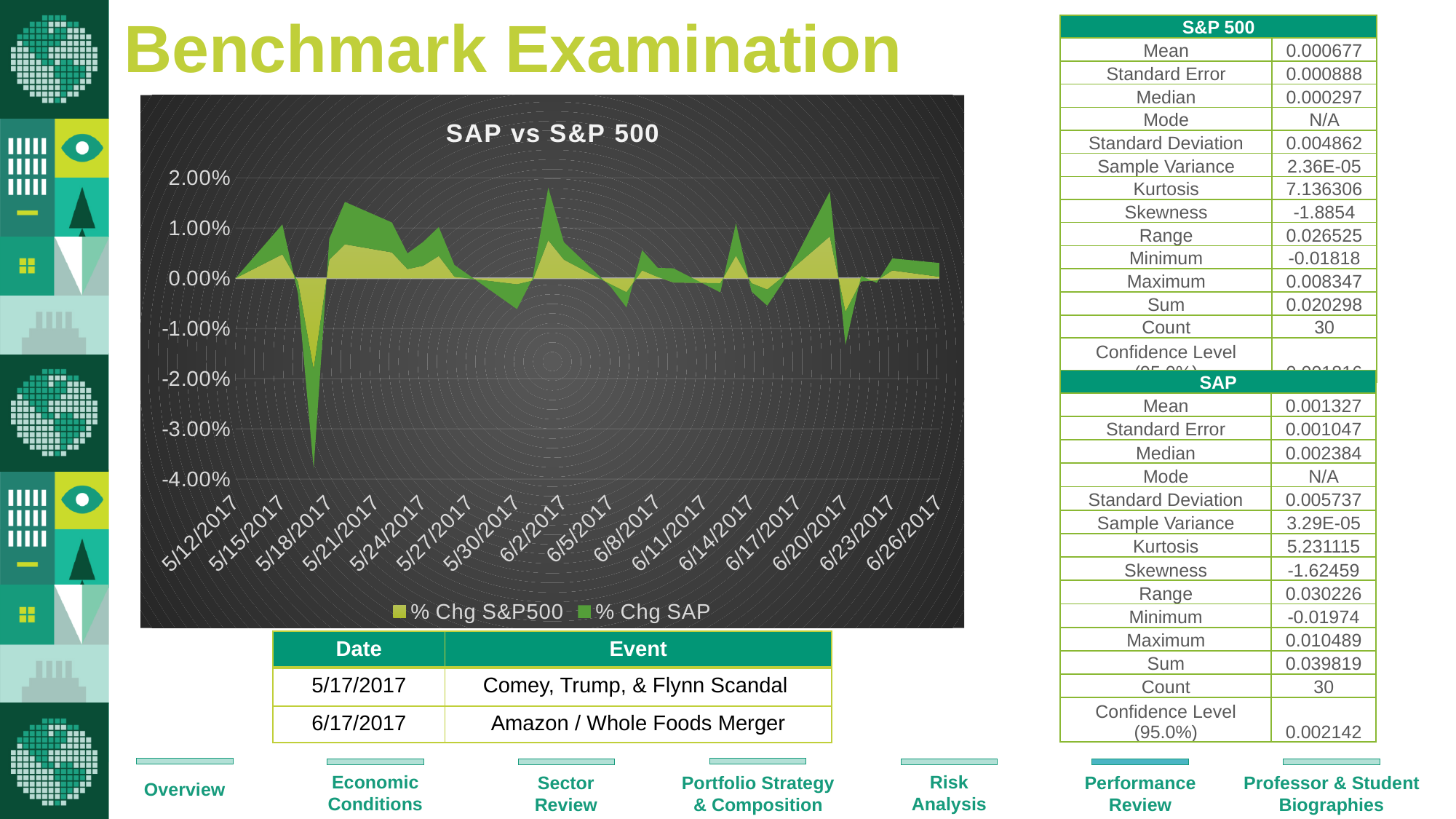
Which series reaches the lowest point on the chart, % Chg S&P500 or % Chg SAP? % Chg SAP What is the first date label on the x axis of the chart? 5/12/2017 What is the highest value shown on the chart's y axis? 2.00% What is the title of the chart? SAP vs S&P 500 What is the lowest value shown on the chart's y axis? -4.00% How many date labels are shown along the x axis of the chart? 16 What type of chart is shown on the slide? Area chart What are the two series named in the chart's legend? % Chg S&P500 and % Chg SAP What is the last date label on the x axis of the chart? 6/26/2017 How many series does the chart's legend list? 2 Is the highest value plotted for % Chg SAP greater or less than 1.00%? greater